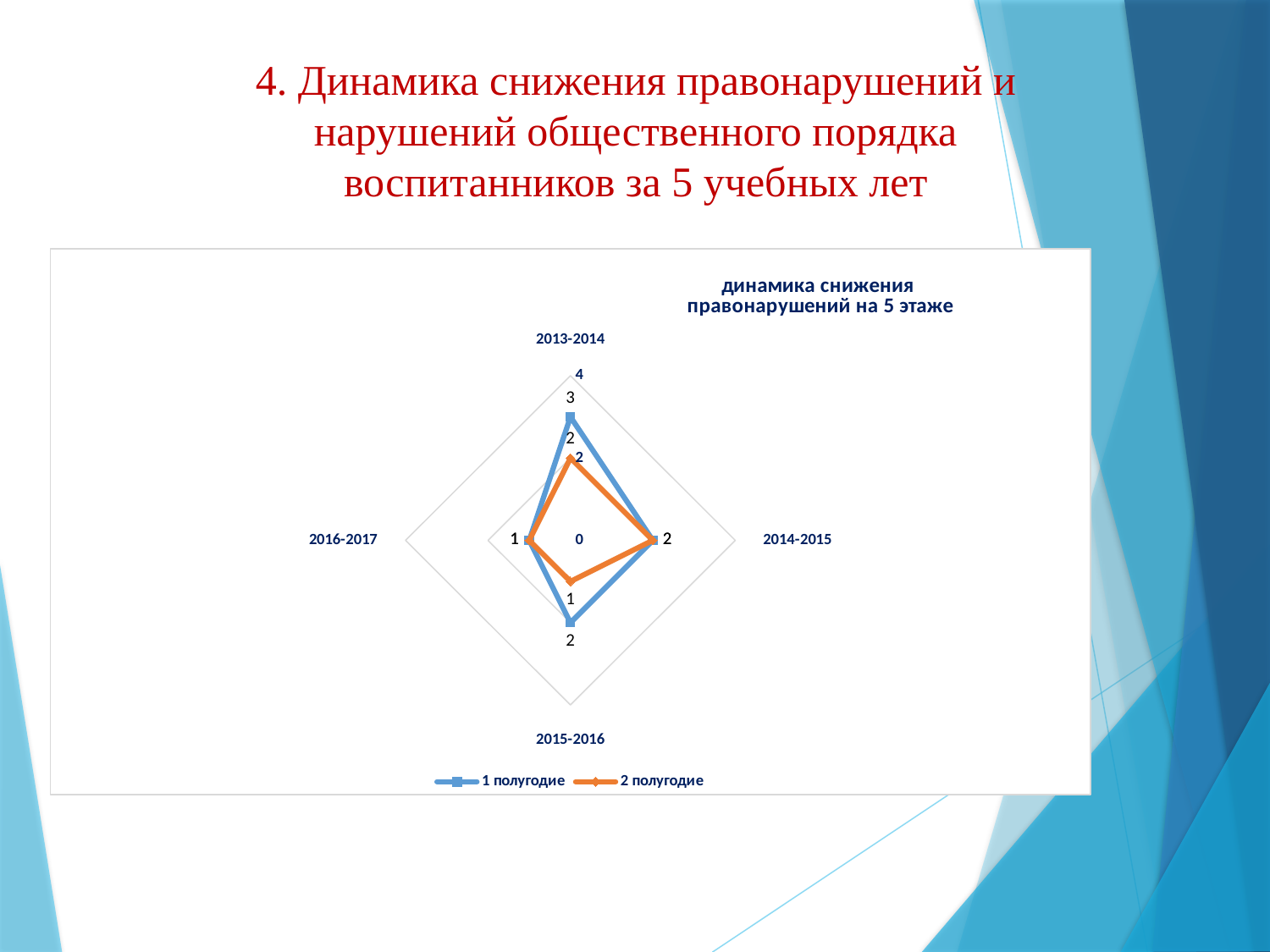
In which academic year does "1 полугодие" reach its highest value? 2013-2014 What is the difference between "1 полугодие" and "2 полугодие" in 2013-2014? 1 What is the value for "2 полугодие" in 2015-2016? 1 What is the value for "2 полугодие" in 2013-2014? 2 What is the title of the chart? динамика снижения правонарушений на 5 этаже What is the value for "1 полугодие" in 2015-2016? 2 What is the value for "1 полугодие" in 2013-2014? 3 What is the value for "1 полугодие" in 2014-2015? 2 In 2015-2016, which series has the larger value, "1 полугодие" or "2 полугодие"? 1 полугодие What kind of chart is shown on the slide? radar chart How many series does the legend list? 2 How many academic-year categories are plotted on the chart? 4